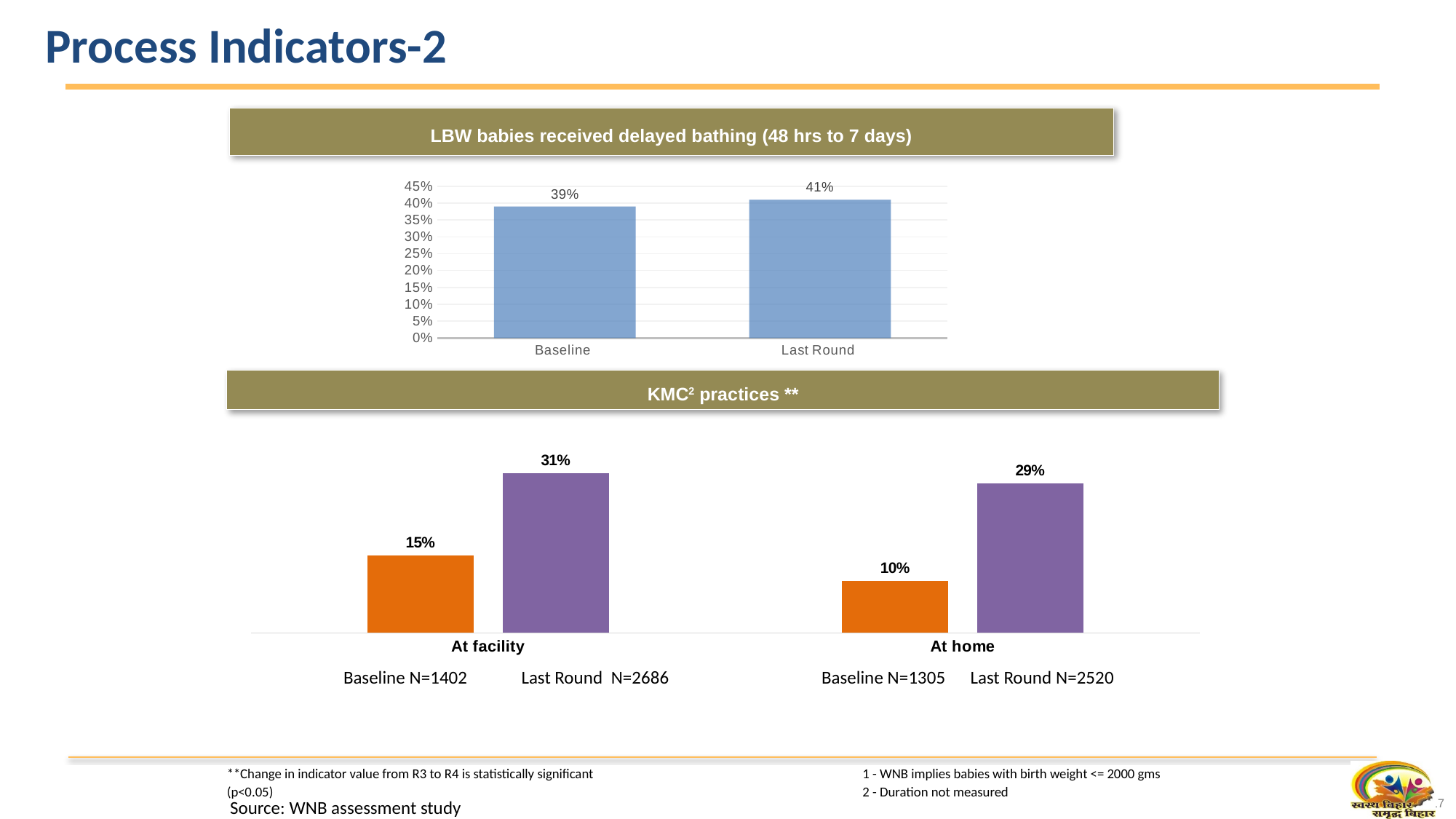
In the 'KMC² practices' chart, what is the Baseline value for At facility? 15% In the 'KMC² practices' chart, which bar has the lowest value? Baseline, At home (10%) In the 'KMC² practices' chart, do the values rise or fall from Baseline to Last Round for At home? Rise What kind of chart is the 'LBW babies received delayed bathing (48 hrs to 7 days)' chart? Bar chart In the 'LBW babies received delayed bathing (48 hrs to 7 days)' chart, how many categories are shown on the x axis? 2 In the 'KMC² practices' chart, which is larger: the Last Round value for At facility or the Last Round value for At home? At facility (31%) In the 'KMC² practices' chart, what is the difference between the Last Round and Baseline values for At facility? 16% In the 'KMC² practices' chart, what is the Last Round value for At home? 29% In the 'LBW babies received delayed bathing (48 hrs to 7 days)' chart, what is the value for Baseline? 39% In the 'LBW babies received delayed bathing (48 hrs to 7 days)' chart, what is the value for Last Round? 41% In the 'KMC² practices' chart, what is the Last Round sample size (N) for At facility? N=2686 In the 'LBW babies received delayed bathing (48 hrs to 7 days)' chart, what is the difference between the Last Round and Baseline values? 2%